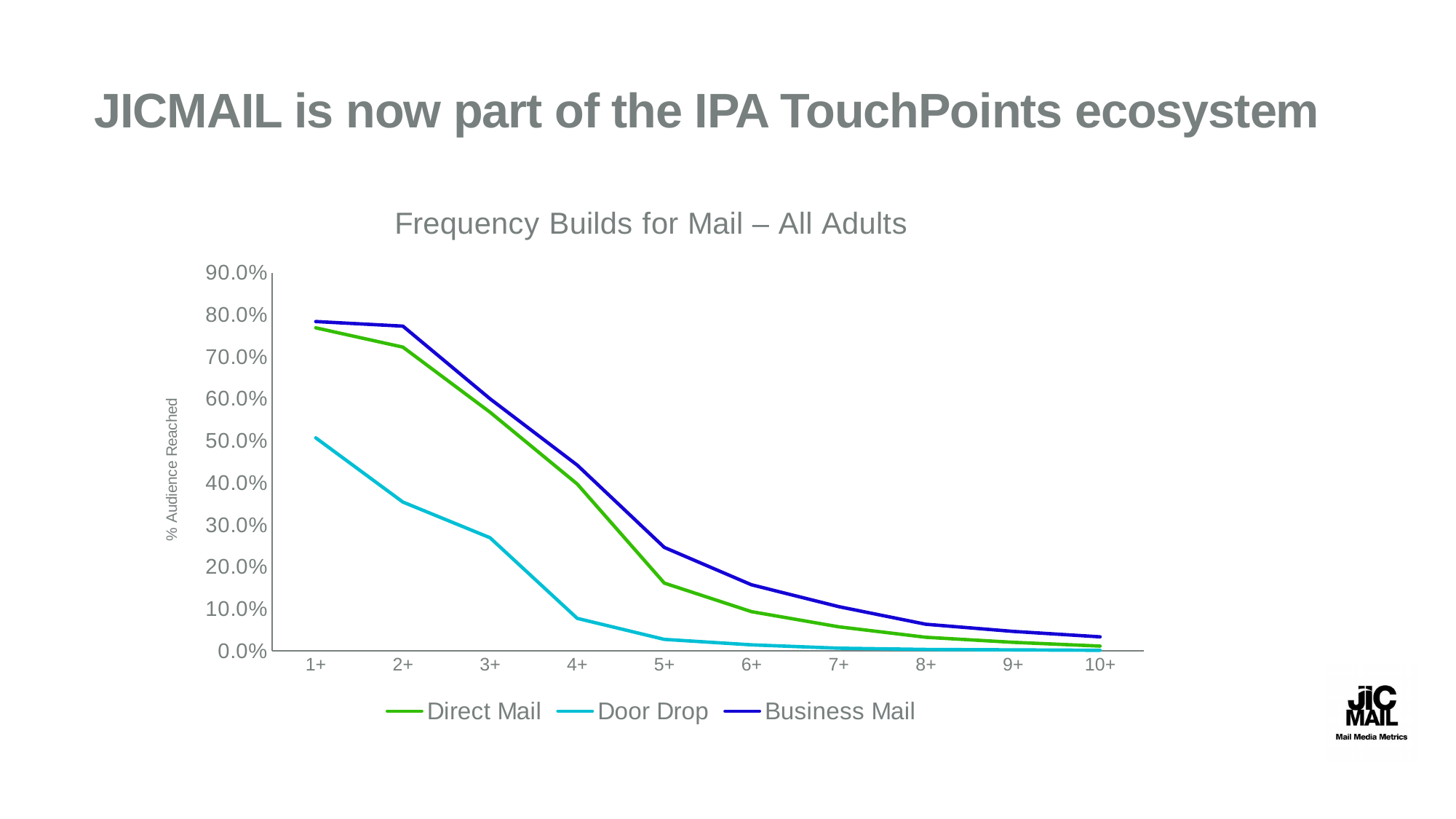
Is the value for Door Drop at 1+ greater or less than 40.0%? greater How many series does the legend list? 3 What is the title of the chart? Frequency Builds for Mail – All Adults What is the label on the vertical axis? % Audience Reached At 5+, which is larger: Direct Mail or Business Mail? Business Mail What kind of chart is shown on the slide? line chart Which series has the highest value at 4+? Business Mail Do the values for Direct Mail rise or fall as frequency increases from 1+ to 10+? fall At 3+, which is larger: Door Drop or Business Mail? Business Mail How many frequency categories are shown along the x axis? 10 Is the value for Direct Mail at 5+ greater or less than 20.0%? less Which series has the lowest value at 2+? Door Drop